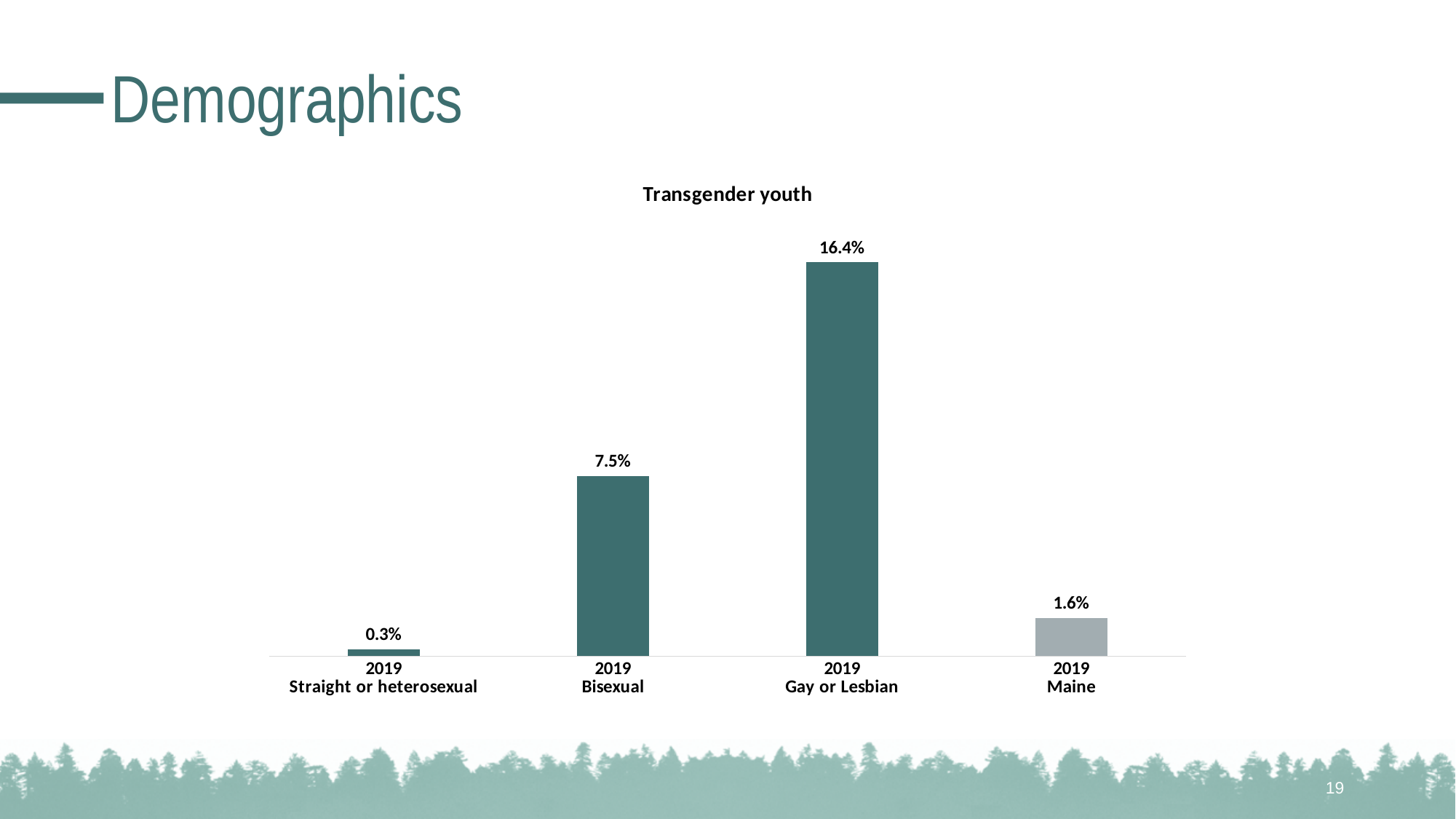
Which category has the lowest value in the Transgender youth chart? Straight or heterosexual Which category has the highest value in the Transgender youth chart? Gay or Lesbian What is the value for Bisexual in the Transgender youth chart? 7.5% What year is shown for all categories in the Transgender youth chart? 2019 What is the value for Gay or Lesbian in the Transgender youth chart? 16.4% What kind of chart is the Transgender youth chart? Bar chart What is the difference between the Gay or Lesbian and Bisexual values in the Transgender youth chart? 8.9% How many bars are shown in the Transgender youth chart? 4 What is the difference between the Maine and Straight or heterosexual values in the Transgender youth chart? 1.3% Which is larger in the Transgender youth chart, the value for Bisexual or the value for Maine? Bisexual What is the value for Maine in the Transgender youth chart? 1.6% What is the value for Straight or heterosexual in the Transgender youth chart? 0.3%